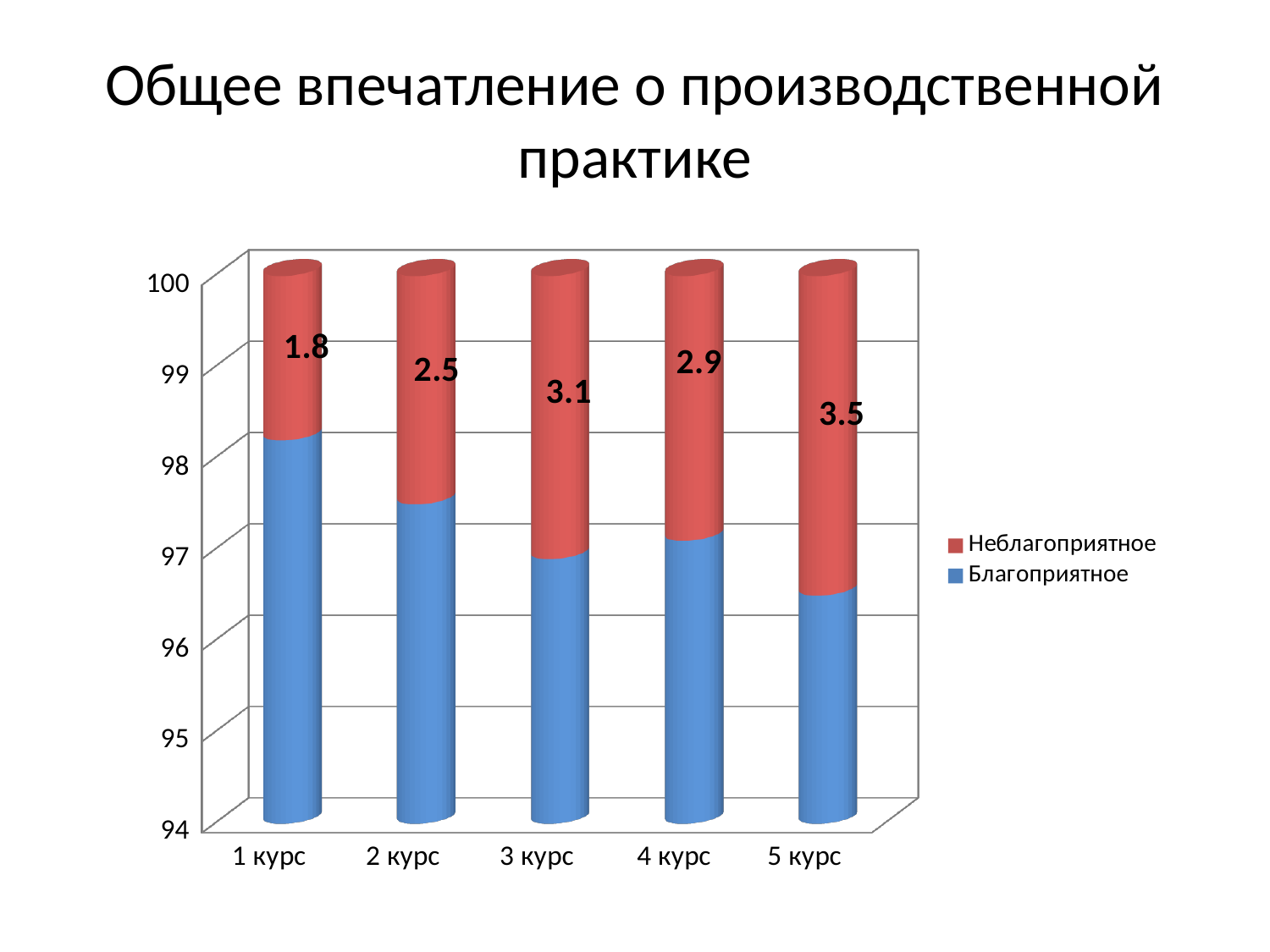
Which has a larger Неблагоприятное value, 3 курс or 4 курс? 3 курс Which course has the lowest value for Неблагоприятное? 1 курс What is the value of Неблагоприятное for 1 курс? 1.8 What is the value of Неблагоприятное for 3 курс? 3.1 What kind of chart is shown on the slide? Stacked bar chart What is the difference between the Неблагоприятное values for 5 курс and 1 курс? 1.7 What colour represents Неблагоприятное in the chart? Red How many courses are shown on the x axis? 5 Which course has the highest value for Неблагоприятное? 5 курс Is the value for Благоприятное for 5 курс greater or less than 97? less What is the value of Неблагоприятное for 5 курс? 3.5 How many series does the legend list? 2